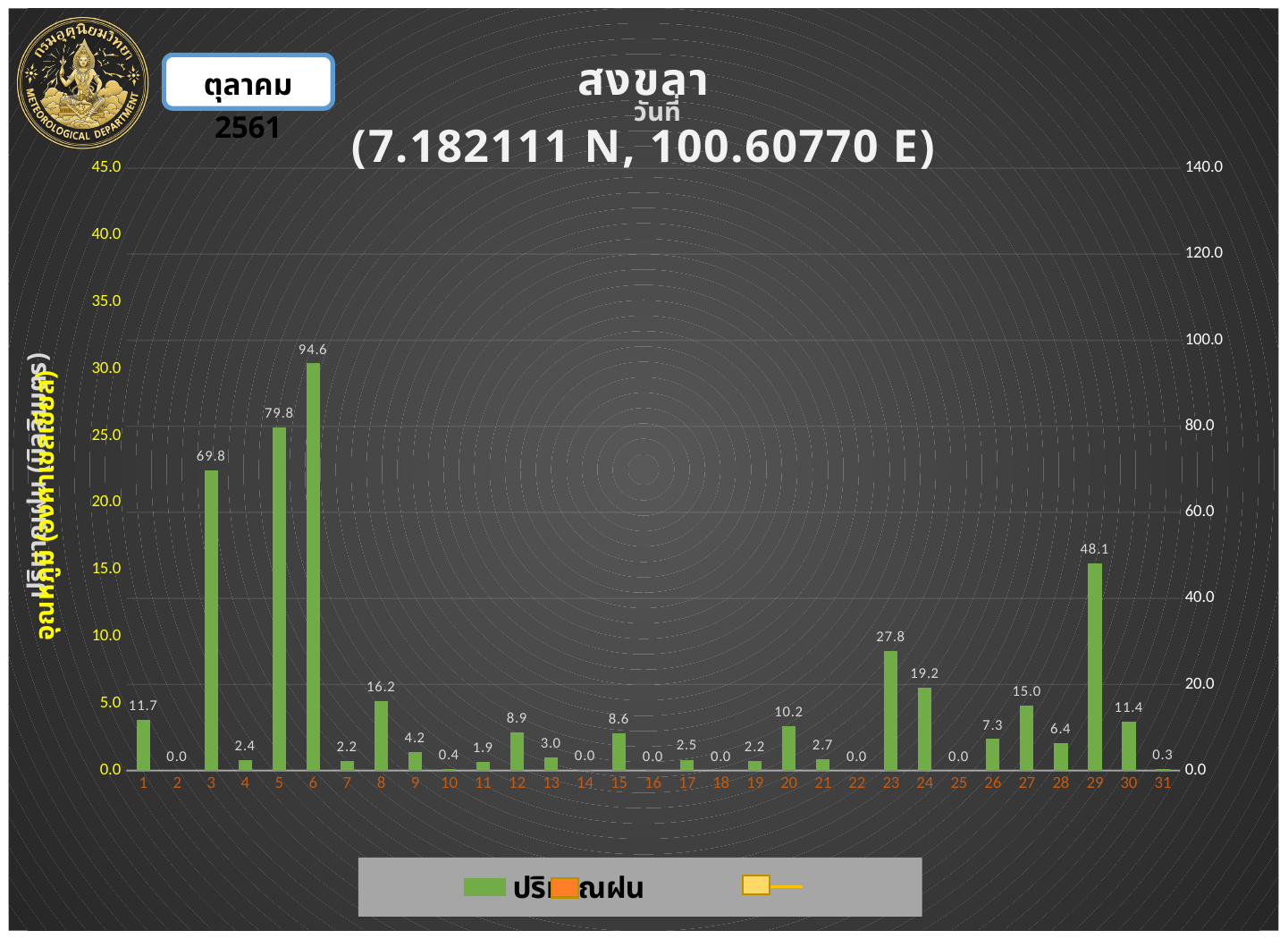
What is the value shown for day 29? 48.1 What is the value shown for day 23? 27.8 Which day has the highest value? 6 What is the value shown for day 31? 0.3 What is the difference between the values for day 6 and day 5? 14.8 Which is larger, the value for day 8 or the value for day 20? day 8 How many days are shown on the x axis? 31 Which is larger, the value for day 24 or the value for day 27? day 24 What kind of chart is this? bar chart What is the value shown for day 6? 94.6 What is the difference between the values for day 3 and day 29? 21.7 What is the value shown for day 1? 11.7